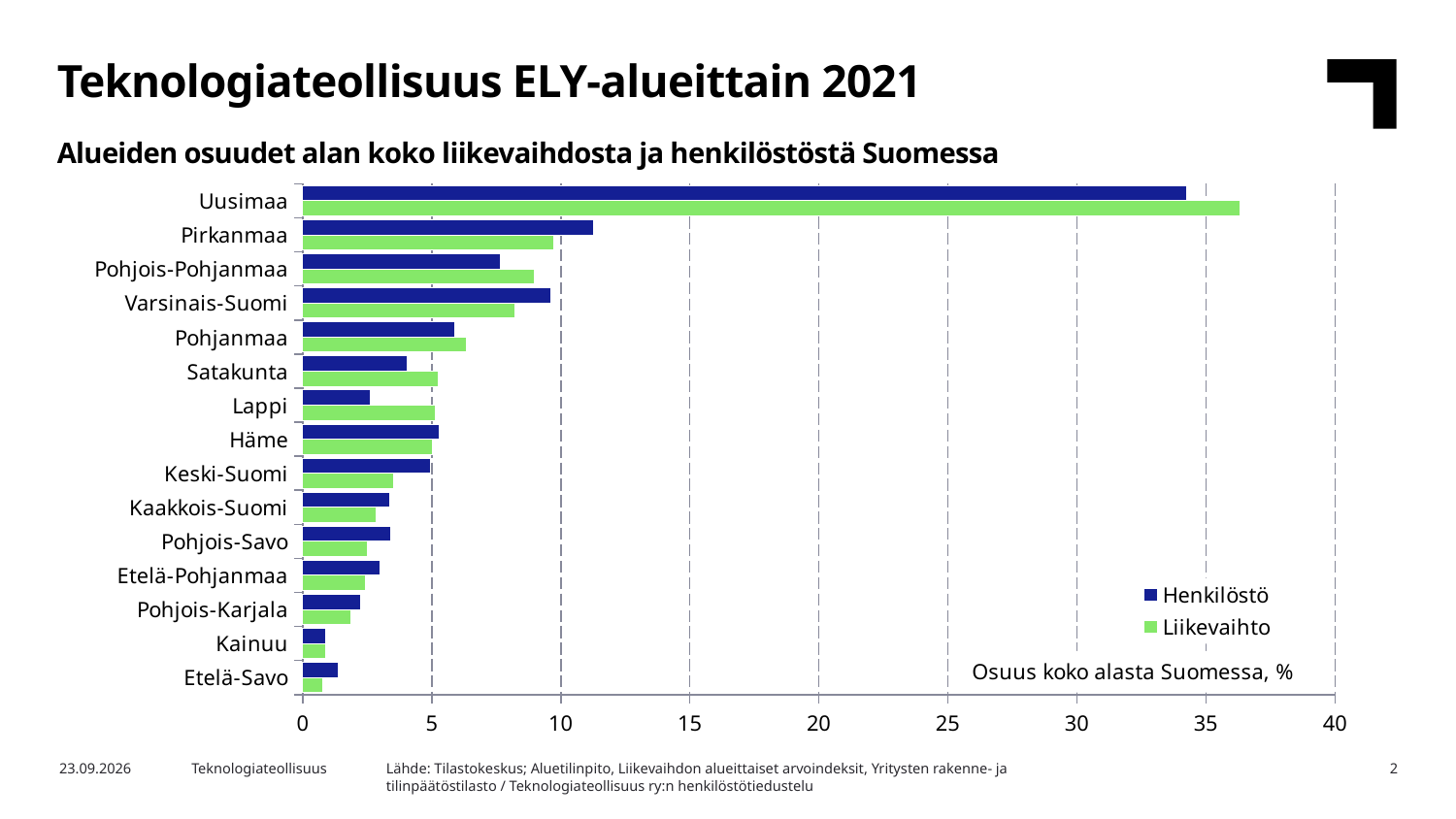
What kind of chart is shown on the slide? bar chart Which region has the lowest Henkilöstö value? Kainuu Which region has the highest Liikevaihto value? Uusimaa How many series does the legend list? 2 Is the Henkilöstö value for Pirkanmaa greater or less than 10? greater How many regions (categories) are shown on the chart? 15 Is the Henkilöstö value for Uusimaa greater or less than 30? greater Is the Henkilöstö value for Satakunta greater or less than 5? less Which region has the highest Henkilöstö value? Uusimaa Which colour represents the Liikevaihto series? green For Lappi, which is larger: Henkilöstö or Liikevaihto? Liikevaihto For Varsinais-Suomi, which is larger: Henkilöstö or Liikevaihto? Henkilöstö